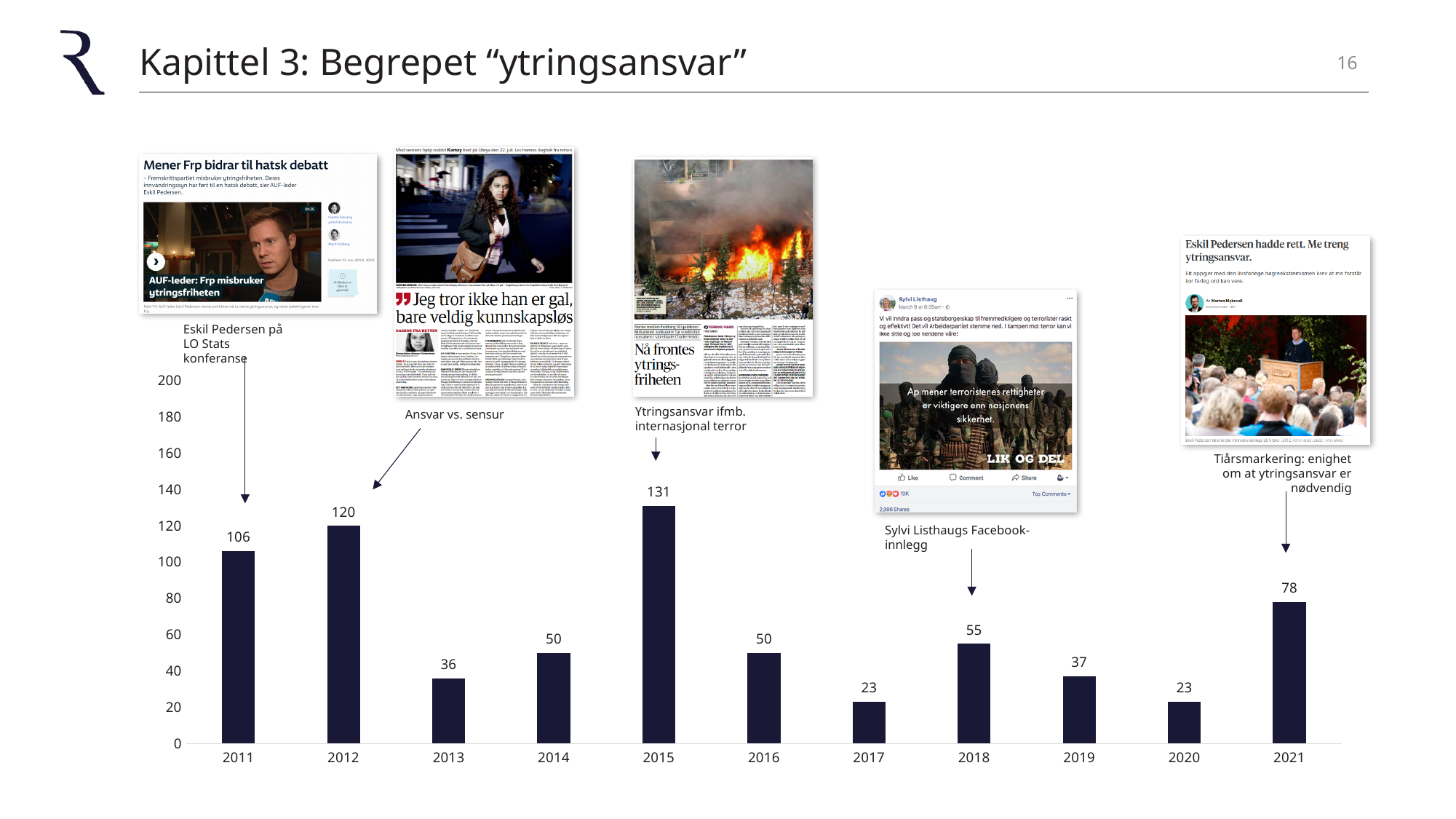
How many years are shown on the x axis? 11 What is the difference between the values for 2012 and 2011? 14 What is the value for 2015? 131 What is the lowest value shown in the chart? 23 What is the value for 2013? 36 Which is larger, the value for 2018 or the value for 2019? 2018 Is the value for 2014 greater or less than 40? greater Which year has the highest value? 2015 What kind of chart is shown on the slide? Bar chart What is the value for 2021? 78 Do the values rise or fall from 2015 to 2017? Fall Which year is annotated with "Sylvi Listhaugs Facebook-innlegg"? 2018